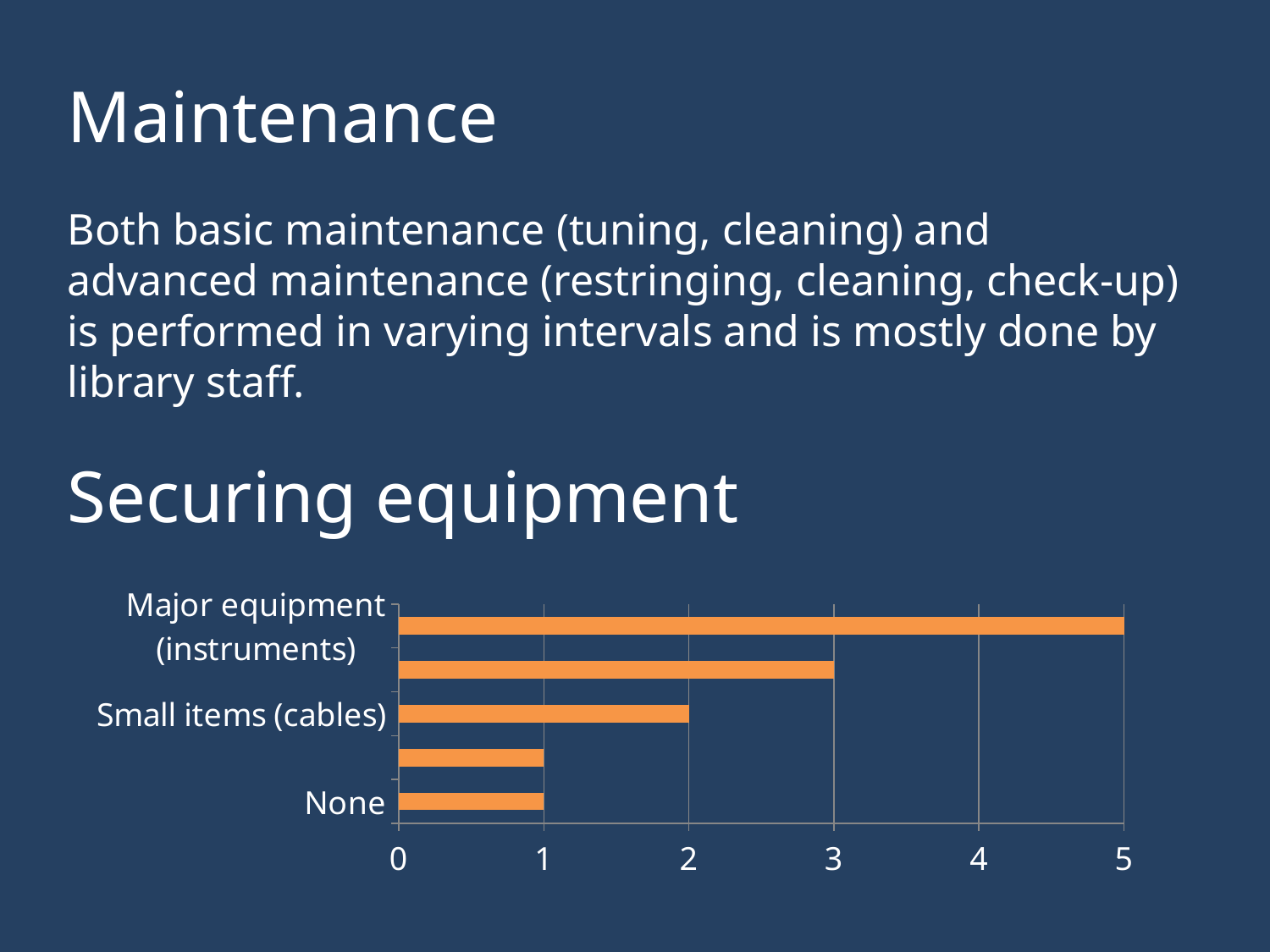
Is the value for Small items (cables) greater or less than 3? less How many bars are plotted in the Securing equipment chart? 5 What is the difference between the values for Major equipment (instruments) and Small items (cables)? 3 What kind of chart is shown on the slide? Bar chart Which category has the highest value in the Securing equipment chart? Major equipment (instruments) What is the difference between the values for Small items (cables) and None? 1 What colour are the bars in the chart? Orange Is the value for Major equipment (instruments) greater or less than 4? greater What is the value for None in the Securing equipment chart? 1 Which is larger, the value for Major equipment (instruments) or the value for Small items (cables)? Major equipment (instruments) What is the value for Major equipment (instruments) in the Securing equipment chart? 5 What is the value for Small items (cables) in the Securing equipment chart? 2